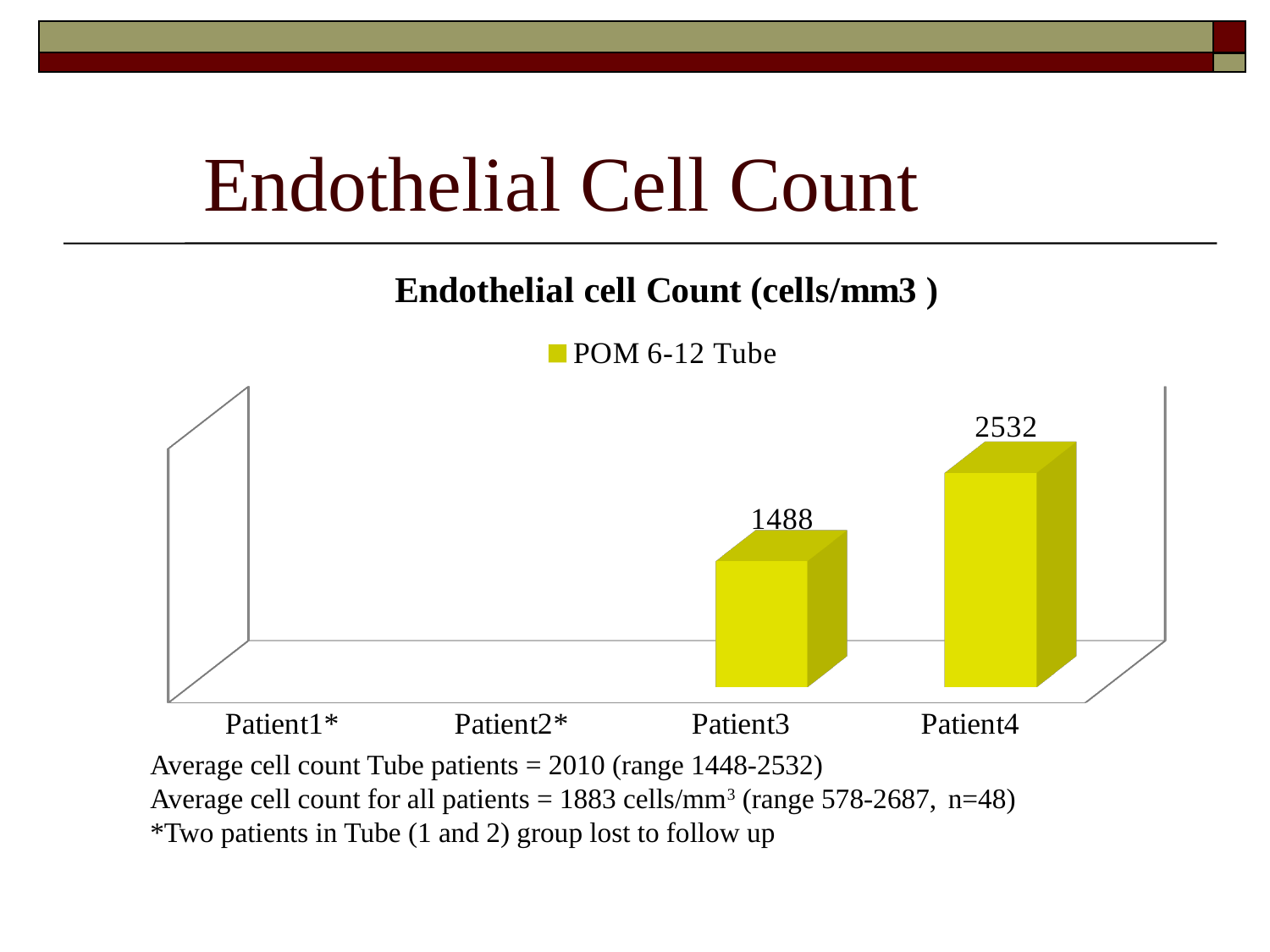
How many patient categories are shown on the x axis of the chart? 4 What is the name of the series listed in the chart legend? POM 6-12 Tube How many patients have a bar plotted on the chart? 2 What is the difference between the cell counts of Patient4 and Patient3? 1044 What is the title of the chart? Endothelial cell Count (cells/mm3 ) What kind of chart is shown on the slide? Bar chart Which patient has the highest endothelial cell count shown on the chart? Patient4 What is the endothelial cell count for Patient4? 2532 What is the endothelial cell count for Patient3? 1488 How many series does the legend list? 1 Which has a larger cell count, Patient3 or Patient4? Patient4